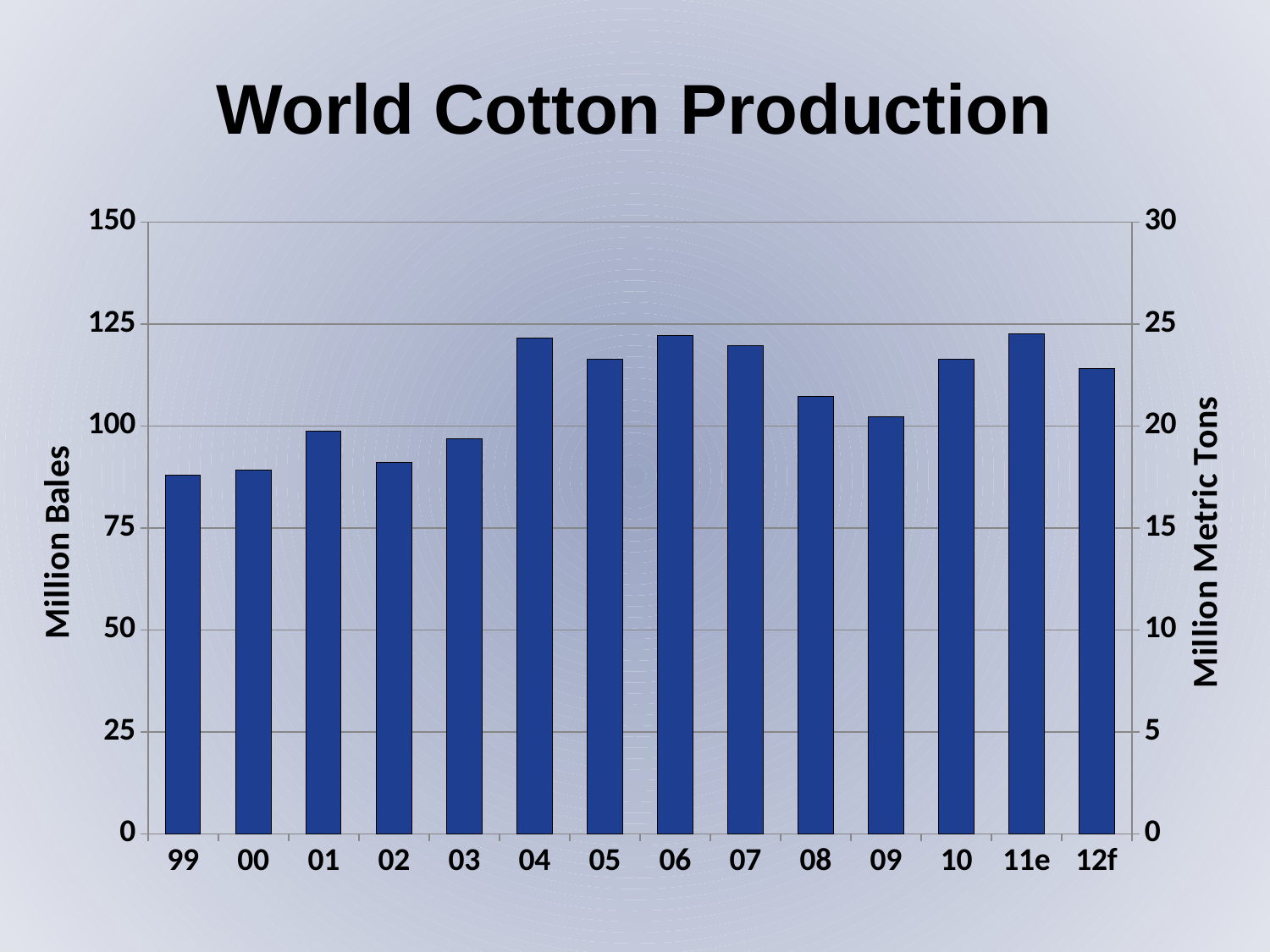
Is the value for 12f greater or less than 100 million bales? greater Is the value for 04 greater or less than 100 million bales? greater What kind of chart is shown on the slide? bar chart What is the label of the left vertical axis? Million Bales Is the value for 02 greater or less than 100 million bales? less Which year has the larger value, 03 or 04? 04 Do the values generally rise or fall from 99 to 04? rise How many bars (years) are plotted in the World Cotton Production chart? 14 What is the title of the chart? World Cotton Production Which year has the larger value, 08 or 07? 07